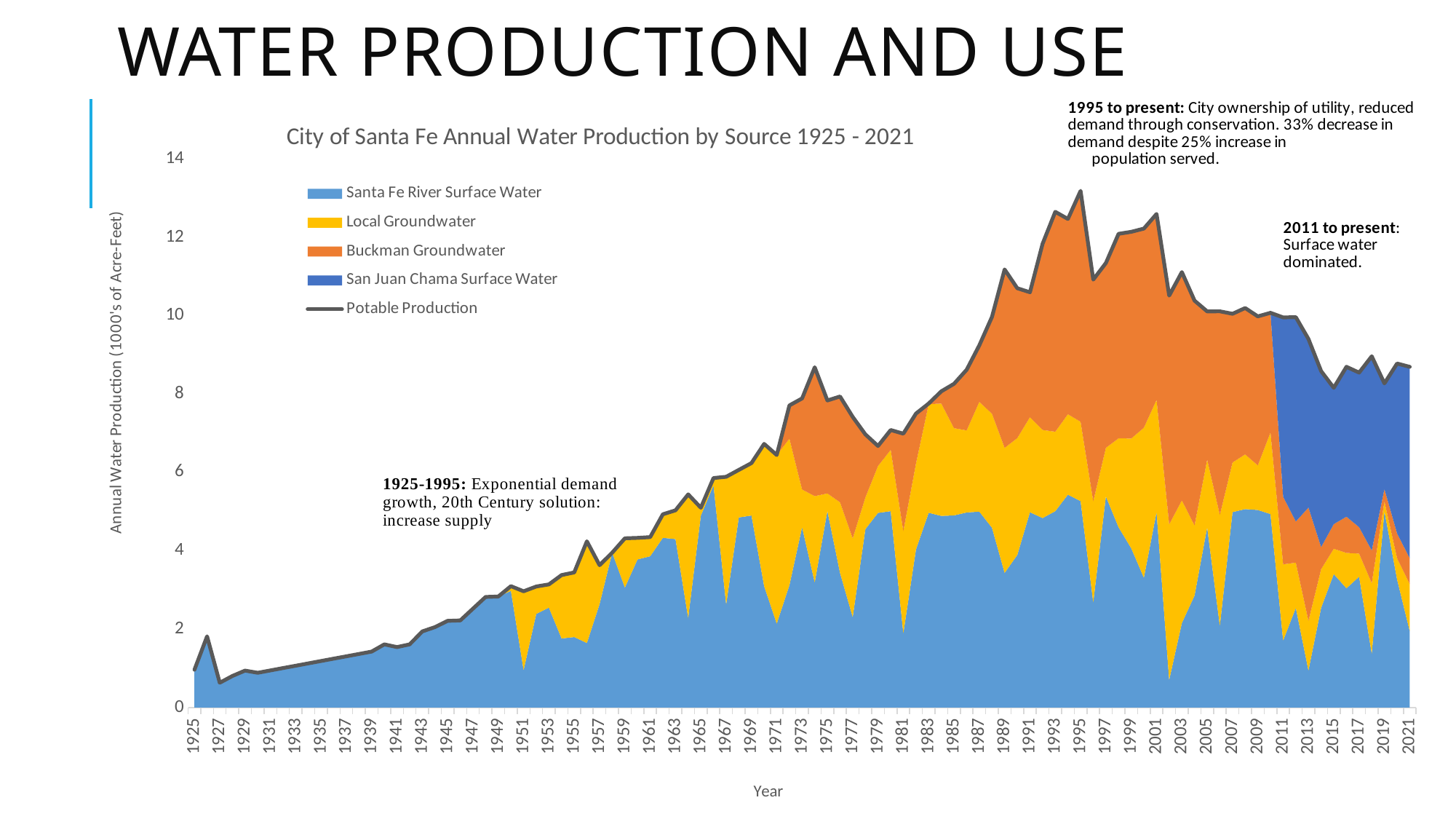
What is the title of the chart? City of Santa Fe Annual Water Production by Source 1925 - 2021 What type of chart is shown on the slide? Stacked area chart with a line overlay In which year does Potable Production reach its highest value? 1995 Is the Potable Production value for 1950 greater or less than 4? less How many series does the legend list? 5 Is the Potable Production value for 1925 greater or less than 2? less Is the Potable Production value for 1995 greater or less than 12? greater Does Potable Production generally rise or fall between 1925 and 1995? rise Which year has higher Potable Production, 1995 or 2021? 1995 In which year is Potable Production at its lowest? 1927 Which water source first appears in the chart around 2011? San Juan Chama Surface Water